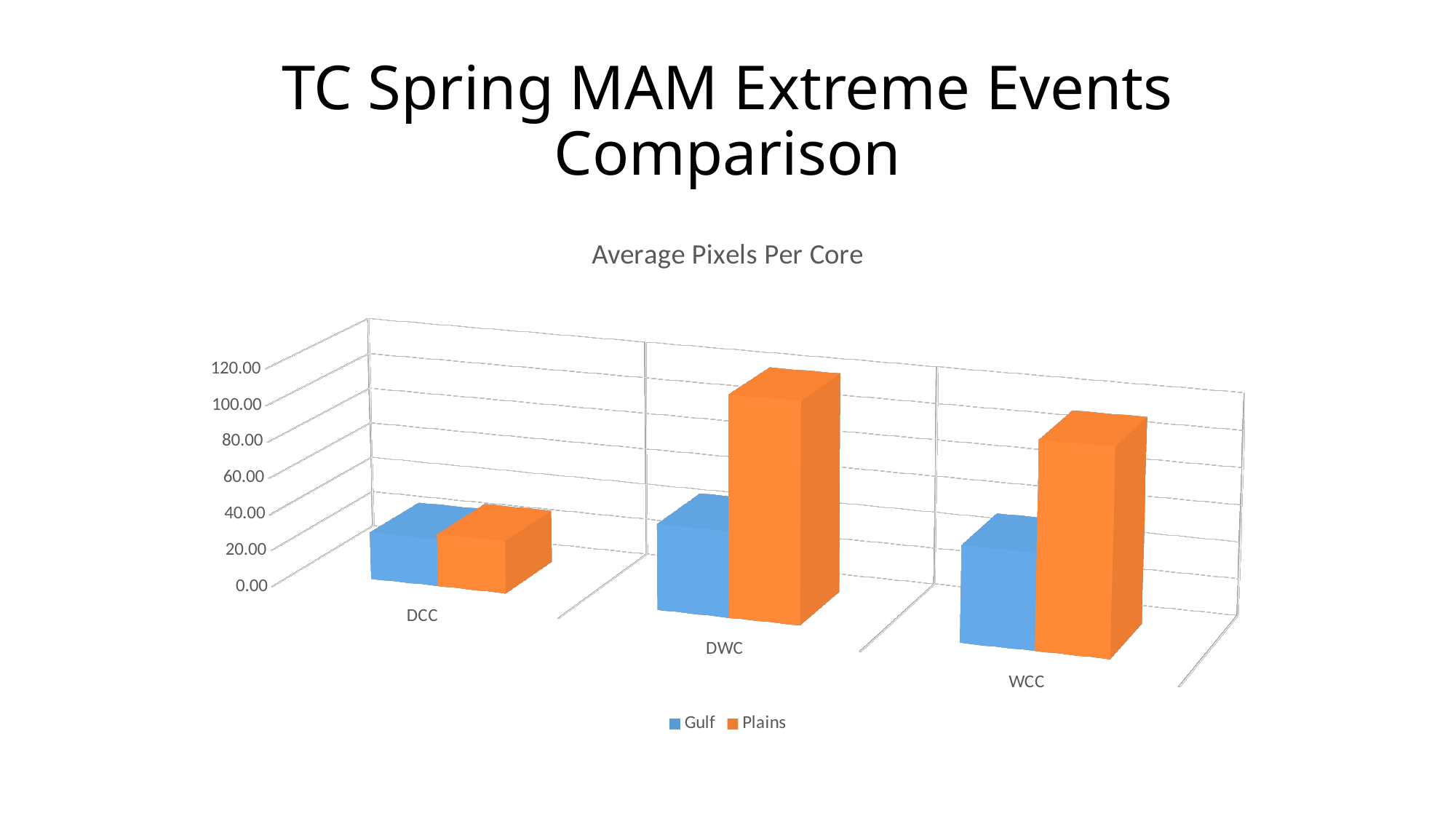
Is the Plains value for DWC greater or less than 80.00? greater What kind of chart is shown on the slide? bar chart Which category has the lowest Plains value? DCC Is the Plains value for WCC greater or less than 60.00? greater What is the title of the chart? Average Pixels Per Core For DWC, which series has the larger value, Gulf or Plains? Plains Is the Gulf value for DCC greater or less than 40.00? less Which category has the highest Plains value? DWC How many categories are shown on the x axis of the chart? 3 Which category has the lowest Gulf value? DCC Which series is shown in orange in the chart? Plains How many series does the legend list? 2